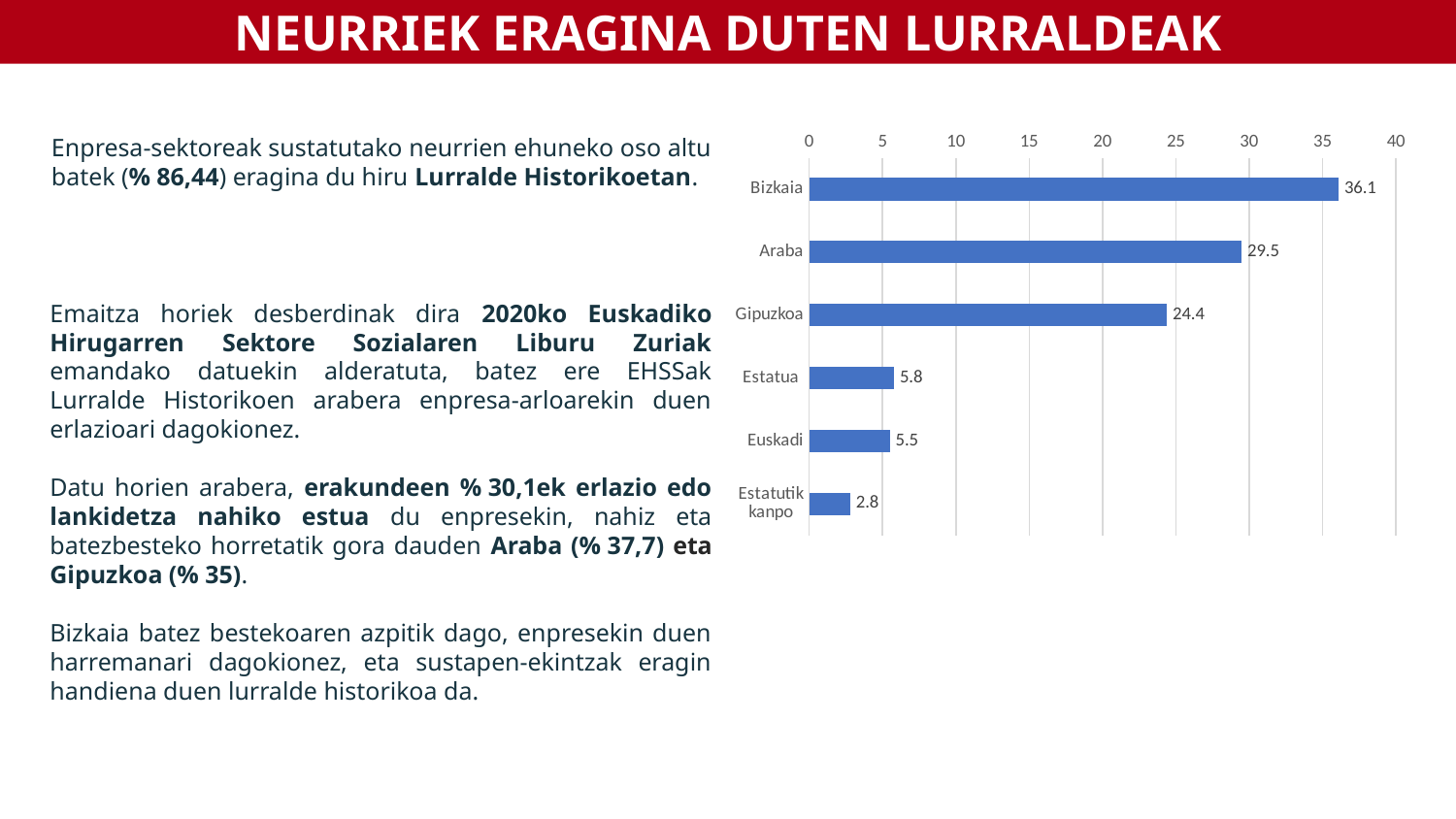
What is the value for Estatutik kanpo? 2.8 What is the difference between the values for Bizkaia and Araba? 6.6 Which is larger, the value for Estatua or the value for Euskadi? Estatua What is the value for Gipuzkoa? 24.4 How many categories are shown in the chart? 6 Is the value for Gipuzkoa greater or less than 25? less Which category has the lowest value? Estatutik kanpo What is the value for Araba? 29.5 What is the difference between the values for Estatua and Euskadi? 0.3 Which category has the highest value? Bizkaia What is the value for Bizkaia? 36.1 What kind of chart is shown on the slide? bar chart